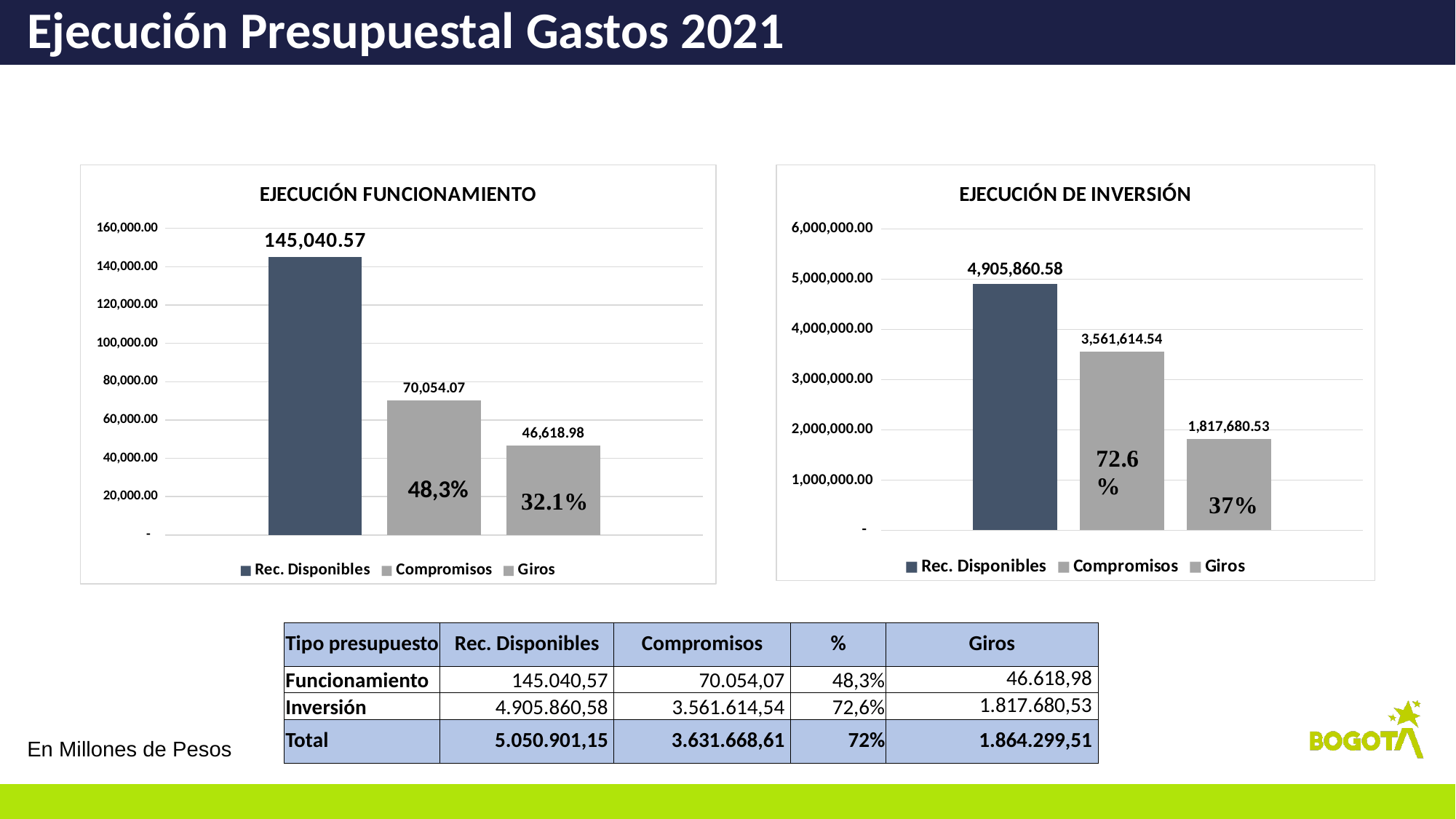
What kind of chart is the EJECUCIÓN DE INVERSIÓN chart? Bar chart In the EJECUCIÓN DE INVERSIÓN chart, which is larger, Compromisos or Giros? Compromisos In the EJECUCIÓN FUNCIONAMIENTO chart, what is the value for Rec. Disponibles? 145,040.57 In the EJECUCIÓN DE INVERSIÓN chart, what is the value for Compromisos? 3,561,614.54 In the EJECUCIÓN DE INVERSIÓN chart, what is the value for Giros? 1,817,680.53 In the EJECUCIÓN FUNCIONAMIENTO chart, what is the difference between Rec. Disponibles and Compromisos? 74,986.50 In the EJECUCIÓN DE INVERSIÓN chart, what is the difference between Compromisos and Giros? 1,743,934.01 In the EJECUCIÓN FUNCIONAMIENTO chart, what is the value for Giros? 46,618.98 How many series does the legend of the EJECUCIÓN FUNCIONAMIENTO chart list? 3 In the EJECUCIÓN DE INVERSIÓN chart, what percentage label is shown on the Giros bar? 37% In the EJECUCIÓN DE INVERSIÓN chart, which series has the highest value? Rec. Disponibles In the EJECUCIÓN FUNCIONAMIENTO chart, which series has the lowest value? Giros